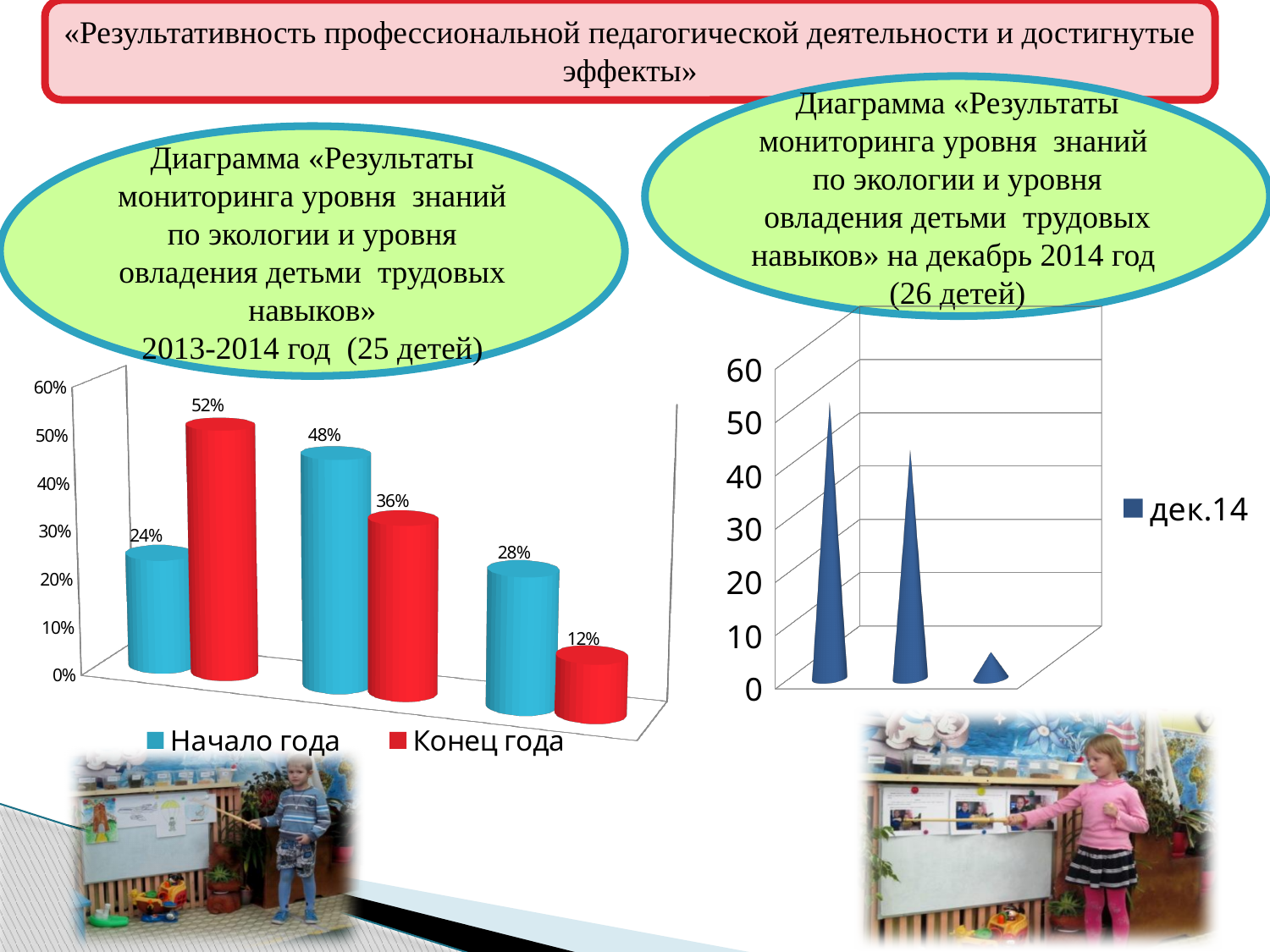
How many series does the legend of the left chart (2013-2014 год, 25 детей) list? 2 How many groups of bars are shown in the left chart (2013-2014 год, 25 детей)? 3 In the left chart (2013-2014 год, 25 детей), by how much does Конец года exceed Начало года in the first group of bars from the left? 28% In the right chart (на декабрь 2014 год, 26 детей), is the value of the first cone from the left greater or less than 40? greater In the left chart (2013-2014 год, 25 детей), what is the lowest value shown on any bar? 12% In the left chart (2013-2014 год, 25 детей), in the third group of bars from the left, which series has the larger value, Начало года or Конец года? Начало года In the left chart (2013-2014 год, 25 детей), what is the highest value shown on any bar? 52% In the right chart (на декабрь 2014 год, 26 детей), is the value of the third cone from the left greater or less than 10? less In the left chart (2013-2014 год, 25 детей), what is the value of Начало года for the first group of bars from the left? 24% In the left chart (2013-2014 год, 25 детей), what is the value of Конец года for the second group of bars from the left? 36% In the left chart (2013-2014 год, 25 детей), do the Конец года values rise or fall from left to right? fall What kind of chart is the left chart (2013-2014 год, 25 детей)? bar chart